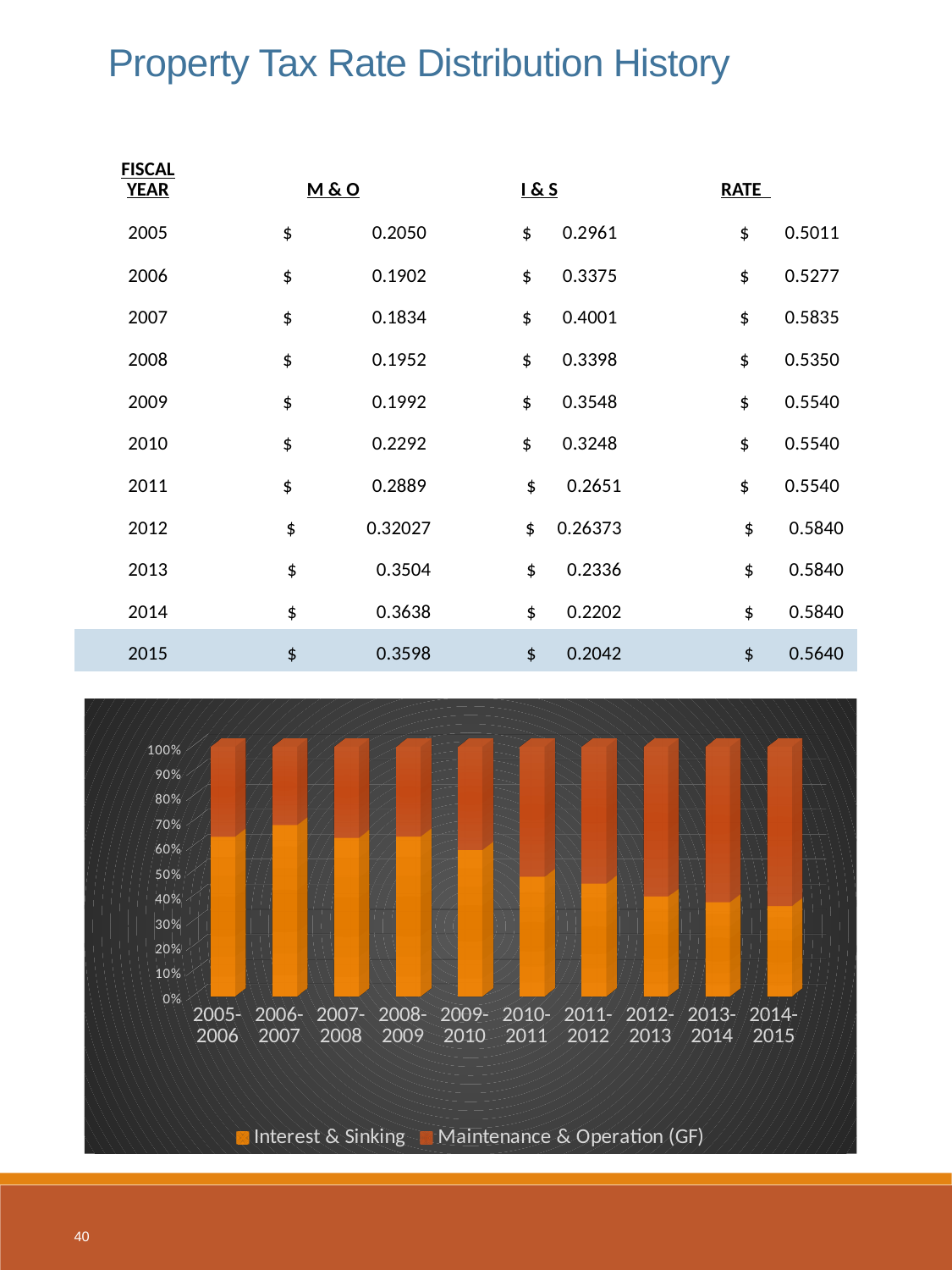
How many fiscal-year categories are plotted along the x axis of the chart? 10 Is the Interest & Sinking share for 2006-2007 greater or less than 60%? greater Is the Interest & Sinking share for 2011-2012 greater or less than 60%? less Is the Interest & Sinking share for 2005-2006 greater or less than 50%? greater What kind of chart is shown on the slide? Stacked bar chart Which fiscal year has the smallest Interest & Sinking share in the chart? 2014-2015 What are the two series named in the chart's legend? Interest & Sinking; Maintenance & Operation (GF) Which has the larger Interest & Sinking share, 2005-2006 or 2014-2015? 2005-2006 Which fiscal year is the first category on the chart's x axis? 2005-2006 How many series does the chart's legend list? 2 Does the Interest & Sinking share generally rise or fall from 2005-2006 to 2014-2015? fall